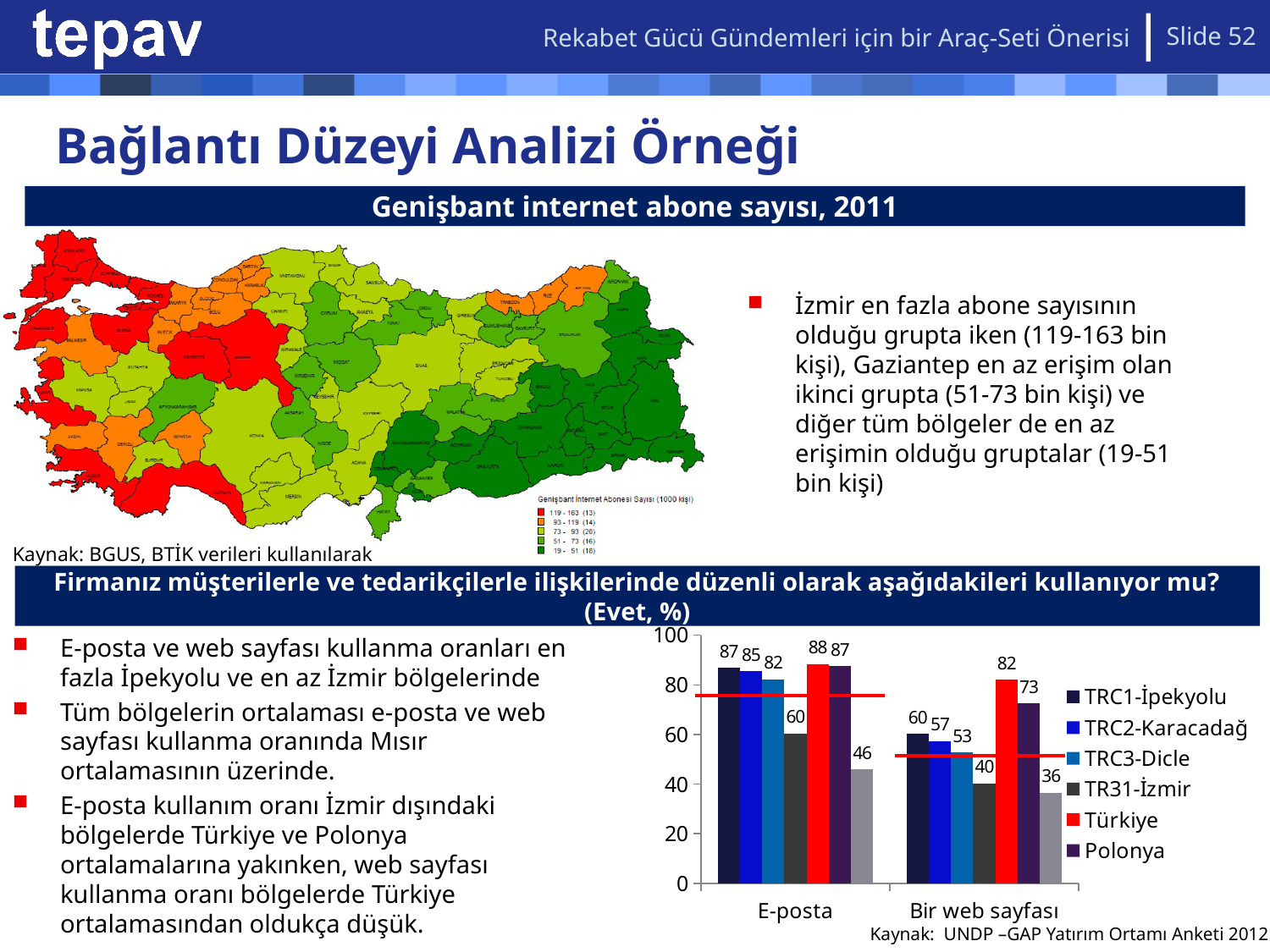
In the bar chart, what is the difference between the Türkiye and TR31-İzmir values in the Bir web sayfası category? 42 How many categories are shown on the x axis of the bar chart? 2 In the bar chart, what is the value for Türkiye in the Bir web sayfası category? 82 In the bar chart, which series has the highest value in the Bir web sayfası category? Türkiye In the bar chart, what is the value for TRC1-İpekyolu in the E-posta category? 87 How many series does the legend of the bar chart list? 6 In the bar chart, which is larger in the E-posta category: TRC2-Karacadağ or TR31-İzmir? TRC2-Karacadağ In the bar chart, what is the value for TRC3-Dicle in the E-posta category? 82 In the bar chart, which of the legend series has the lowest value in the E-posta category? TR31-İzmir In the bar chart, is the value for Polonya in the Bir web sayfası category greater or less than 60? greater What kind of chart is shown at the bottom right of the slide? Bar chart In the bar chart, what is the value for TR31-İzmir in the Bir web sayfası category? 40